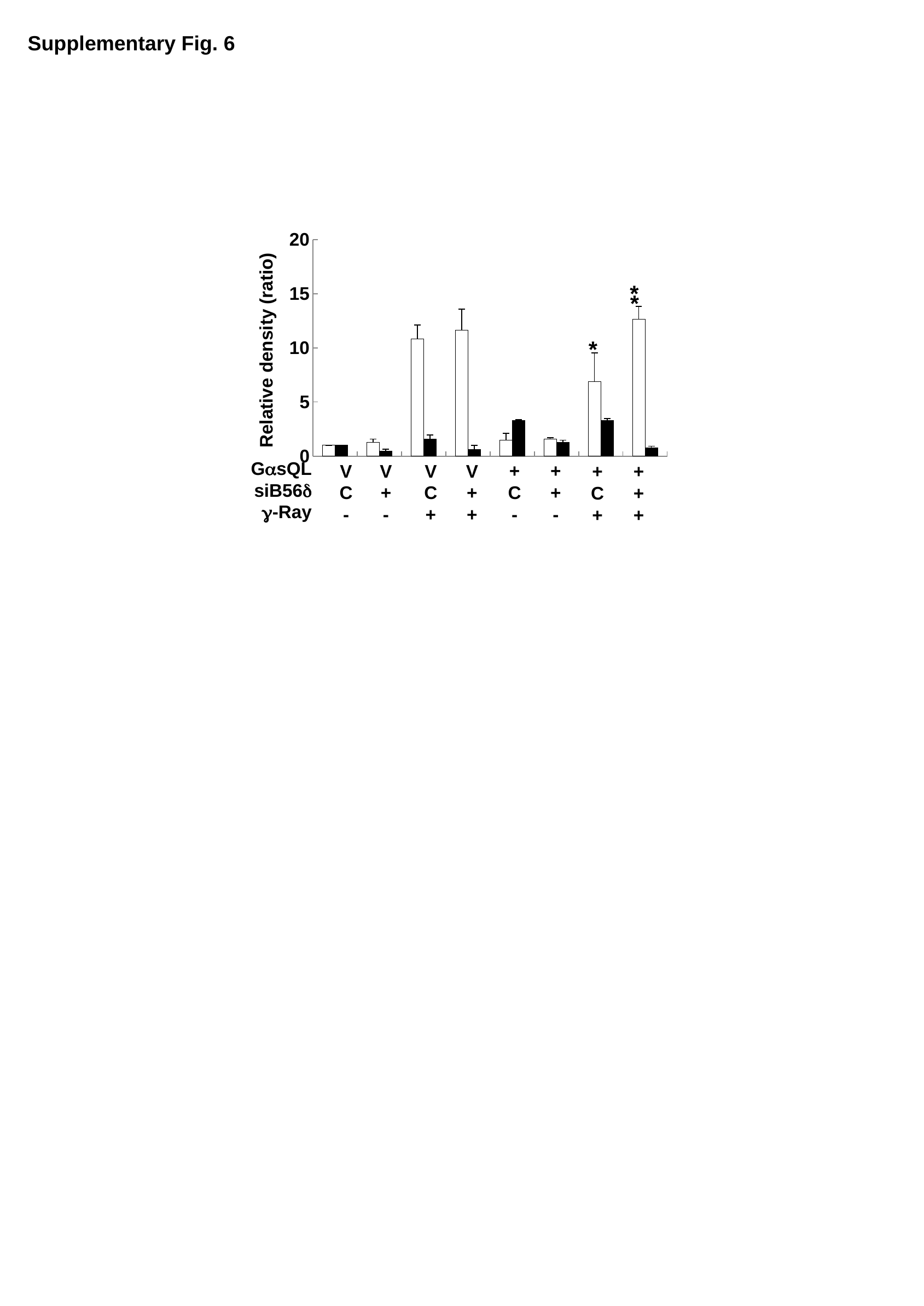
Is the white bar for the group GαsQL +, siB56δ C, γ-Ray + greater or less than 5? greater In the group GαsQL +, siB56δ +, γ-Ray +, which bar is taller, the white bar or the black bar? white bar How many bars are there in each group along the x axis? 2 What is the label of the y axis? Relative density (ratio) What kind of chart is shown on the slide? bar chart How many groups of bars are plotted along the x axis? 8 Is the white bar for the group GαsQL V, siB56δ C, γ-Ray - greater or less than 5? less What is the highest tick value shown on the y axis? 20 Is the white bar for the group GαsQL V, siB56δ C, γ-Ray + greater or less than 5? greater In the group GαsQL +, siB56δ C, γ-Ray -, which bar is taller, the white bar or the black bar? black bar